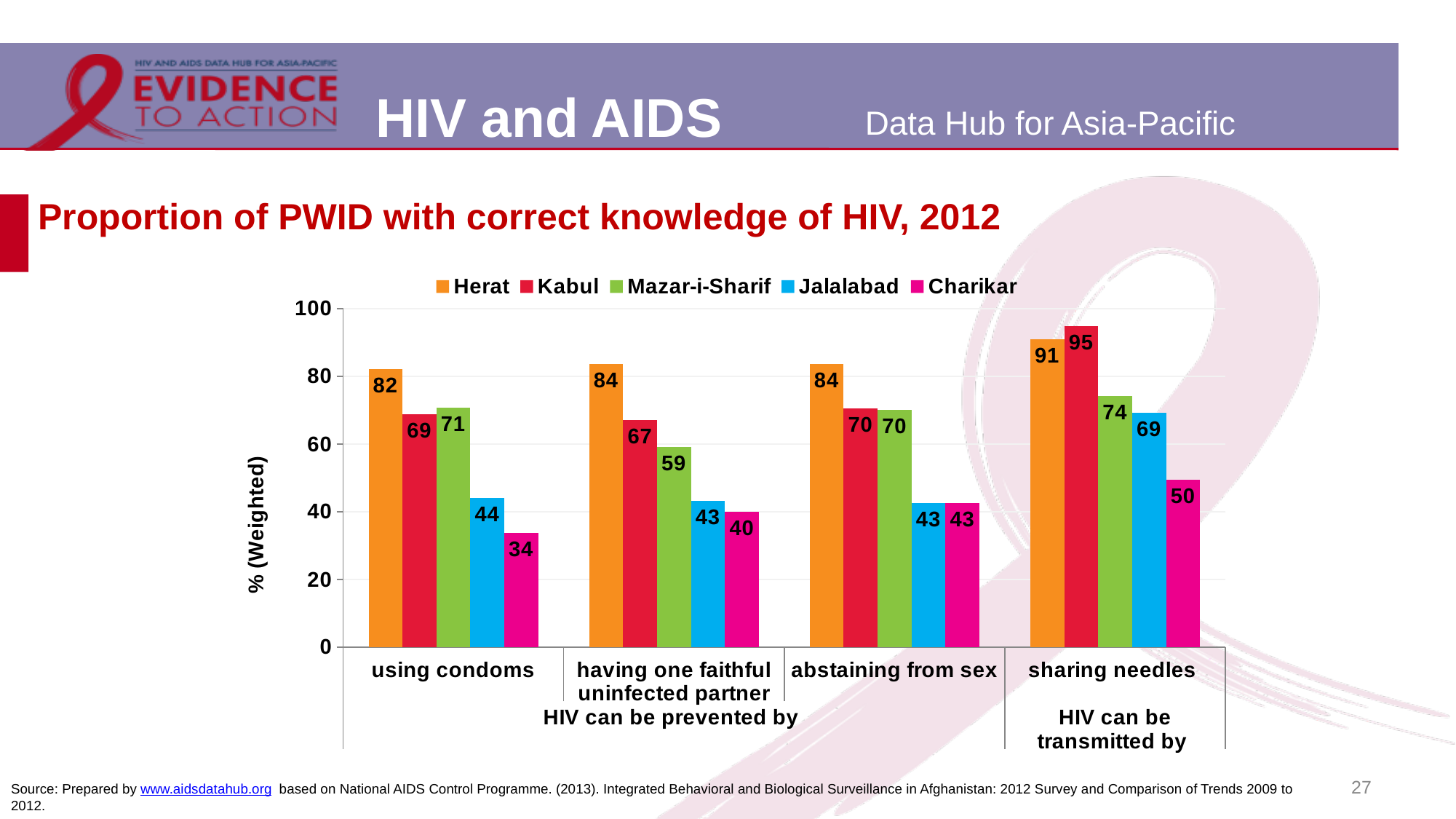
What is the value for Mazar-i-Sharif for 'having one faithful uninfected partner'? 59 What is the value for Charikar for 'using condoms'? 34 Which city has the highest value for 'sharing needles'? Kabul What is the difference between Herat and Charikar for 'using condoms'? 48 How many knowledge categories are shown on the x axis? 4 Is the value for Jalalabad for 'sharing needles' greater or less than 60? greater What is the label of the y axis? % (Weighted) How many series does the legend list? 5 Which city has the lowest value for 'abstaining from sex'? Jalalabad and Charikar (both 43) What kind of chart is shown on the slide? Bar chart Which is larger: Kabul for 'using condoms' or Kabul for 'having one faithful uninfected partner'? Kabul for 'using condoms' (69) What is the value for Herat for 'sharing needles'? 91